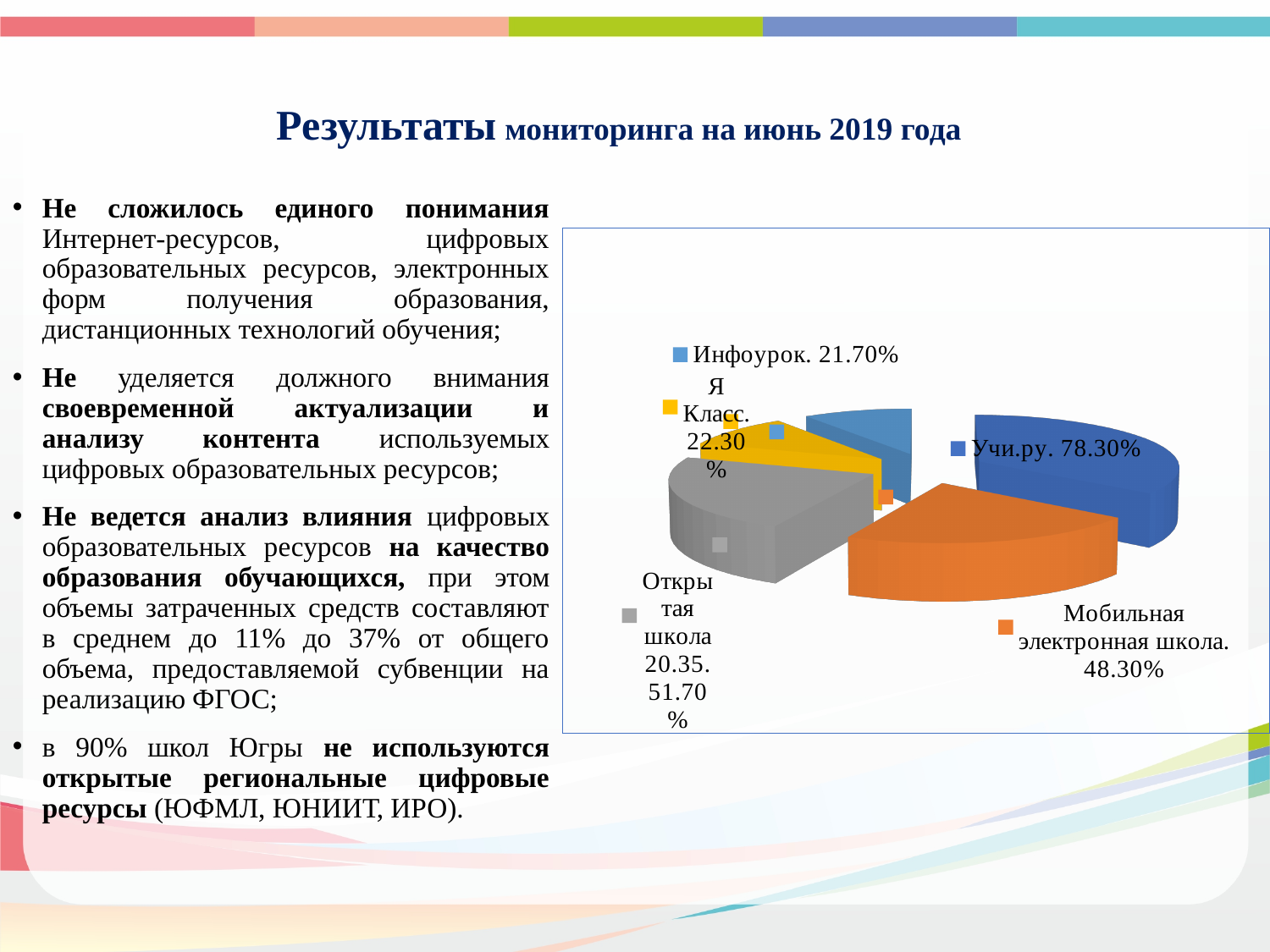
Which has a larger value, Учи.ру or Мобильная электронная школа? Учи.ру What value is shown for Мобильная электронная школа in the pie chart? 48.30% Which category has the lowest labelled value in the pie chart? Инфоурок What value is shown for Учи.ру in the pie chart? 78.30% What colour is the Учи.ру slice in the pie chart? blue How many slices does the pie chart have? 5 What is the difference between the values for Учи.ру and Мобильная электронная школа? 30.00% Which category has the highest value in the pie chart? Учи.ру What value is shown for Инфоурок in the pie chart? 21.70% What value is shown for ЯКласс in the pie chart? 22.30% Which has a larger value, ЯКласс or Инфоурок? ЯКласс What kind of chart is shown on the slide? pie chart